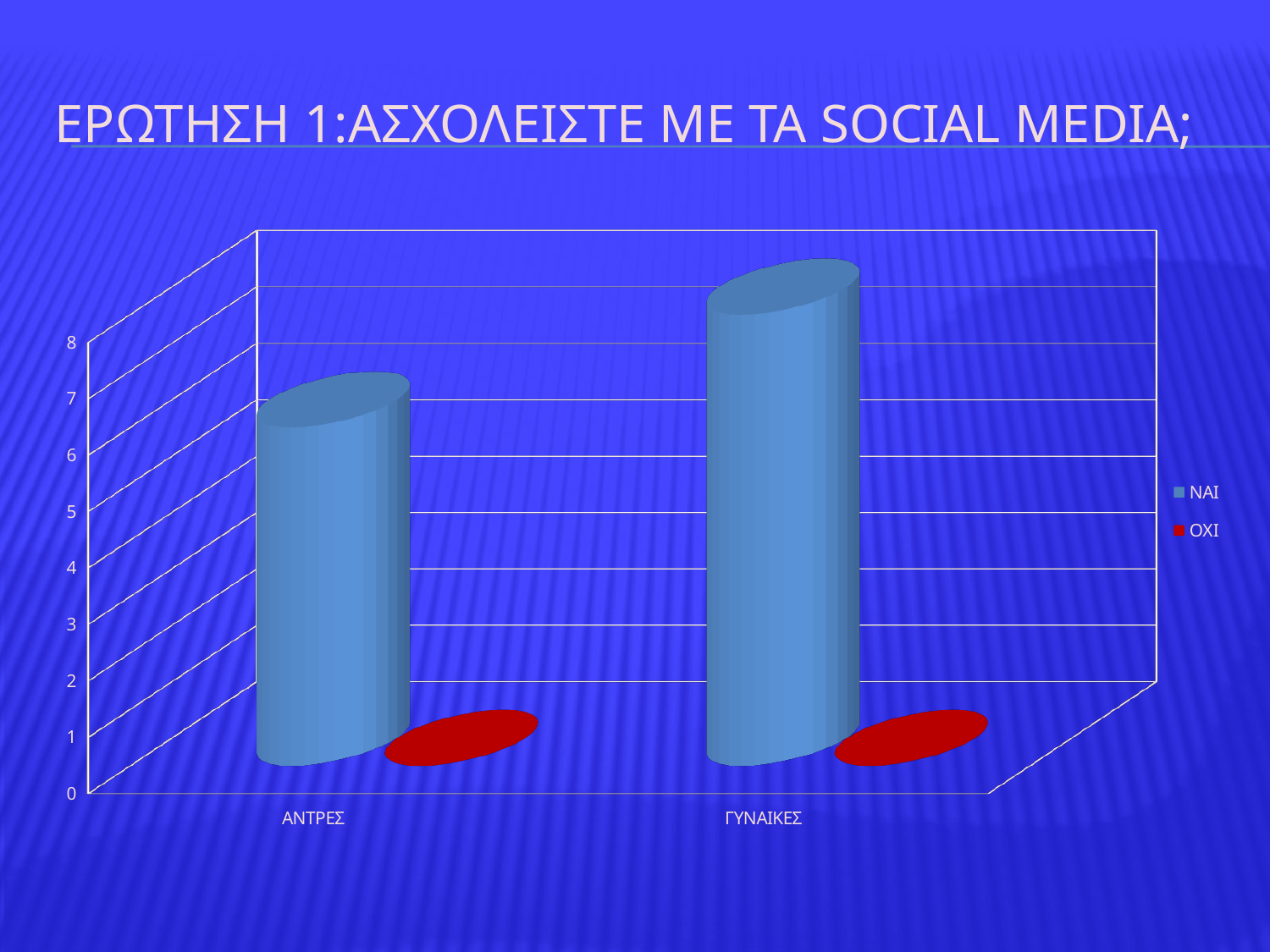
What are the two series names listed in the chart's legend? ΝΑΙ and ΟΧΙ Which category has the highest ΝΑΙ value? ΓΥΝΑΙΚΕΣ Is the ΟΧΙ value for ΓΥΝΑΙΚΕΣ greater or less than 1? less Which category has the higher ΝΑΙ value, ΑΝΤΡΕΣ or ΓΥΝΑΙΚΕΣ? ΓΥΝΑΙΚΕΣ Is the ΟΧΙ value for ΑΝΤΡΕΣ greater or less than 1? less Is the ΝΑΙ value for ΑΝΤΡΕΣ greater or less than 4? greater What kind of chart is shown on the slide? bar chart Which category has the lowest ΝΑΙ value? ΑΝΤΡΕΣ How many categories are shown on the x axis of the chart? 2 What colour represents the ΟΧΙ series in the chart? red How many series does the chart's legend list? 2